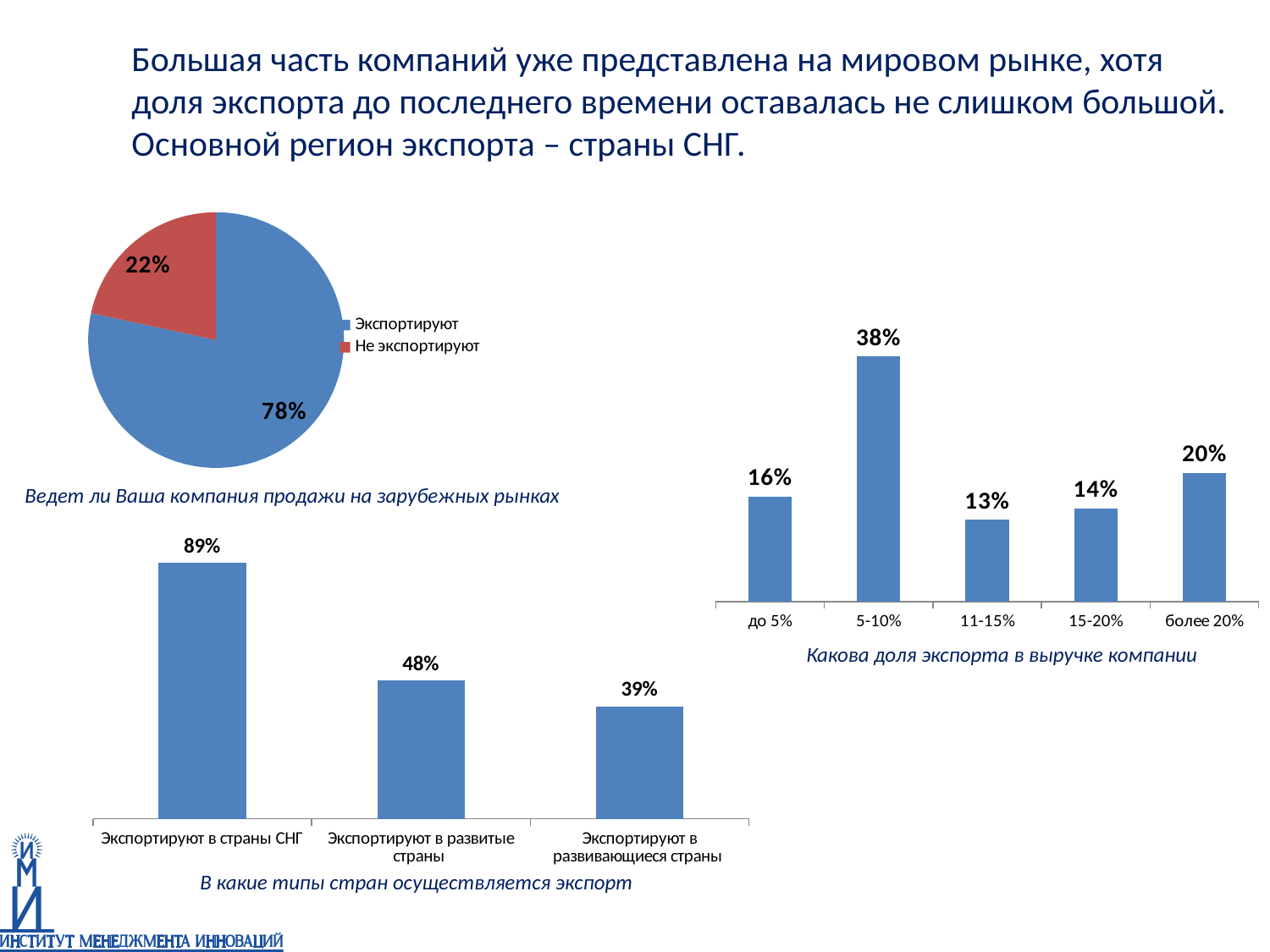
How many categories are shown in the chart 'Какова доля экспорта в выручке компании'? 5 In the chart 'В какие типы стран осуществляется экспорт', what is the difference between 'Экспортируют в страны СНГ' and 'Экспортируют в развитые страны'? 41% How many entries does the legend of the pie chart 'Ведет ли Ваша компания продажи на зарубежных рынках' list? 2 In the pie chart 'Ведет ли Ваша компания продажи на зарубежных рынках', what share is labelled 'Не экспортируют'? 22% How many categories are shown in the chart 'В какие типы стран осуществляется экспорт'? 3 In the chart 'Какова доля экспорта в выручке компании', which is larger: 'до 5%' or 'более 20%'? более 20% In the chart 'В какие типы стран осуществляется экспорт', what is the value for 'Экспортируют в страны СНГ'? 89% In the chart 'Какова доля экспорта в выручке компании', what is the value for '5-10%'? 38% What type of chart is 'Ведет ли Ваша компания продажи на зарубежных рынках'? pie chart In the chart 'Какова доля экспорта в выручке компании', which category has the lowest value? 11-15% In the pie chart 'Ведет ли Ваша компания продажи на зарубежных рынках', what share of companies is labelled 'Экспортируют'? 78% In the chart 'В какие типы стран осуществляется экспорт', which category has the lowest value? Экспортируют в развивающиеся страны